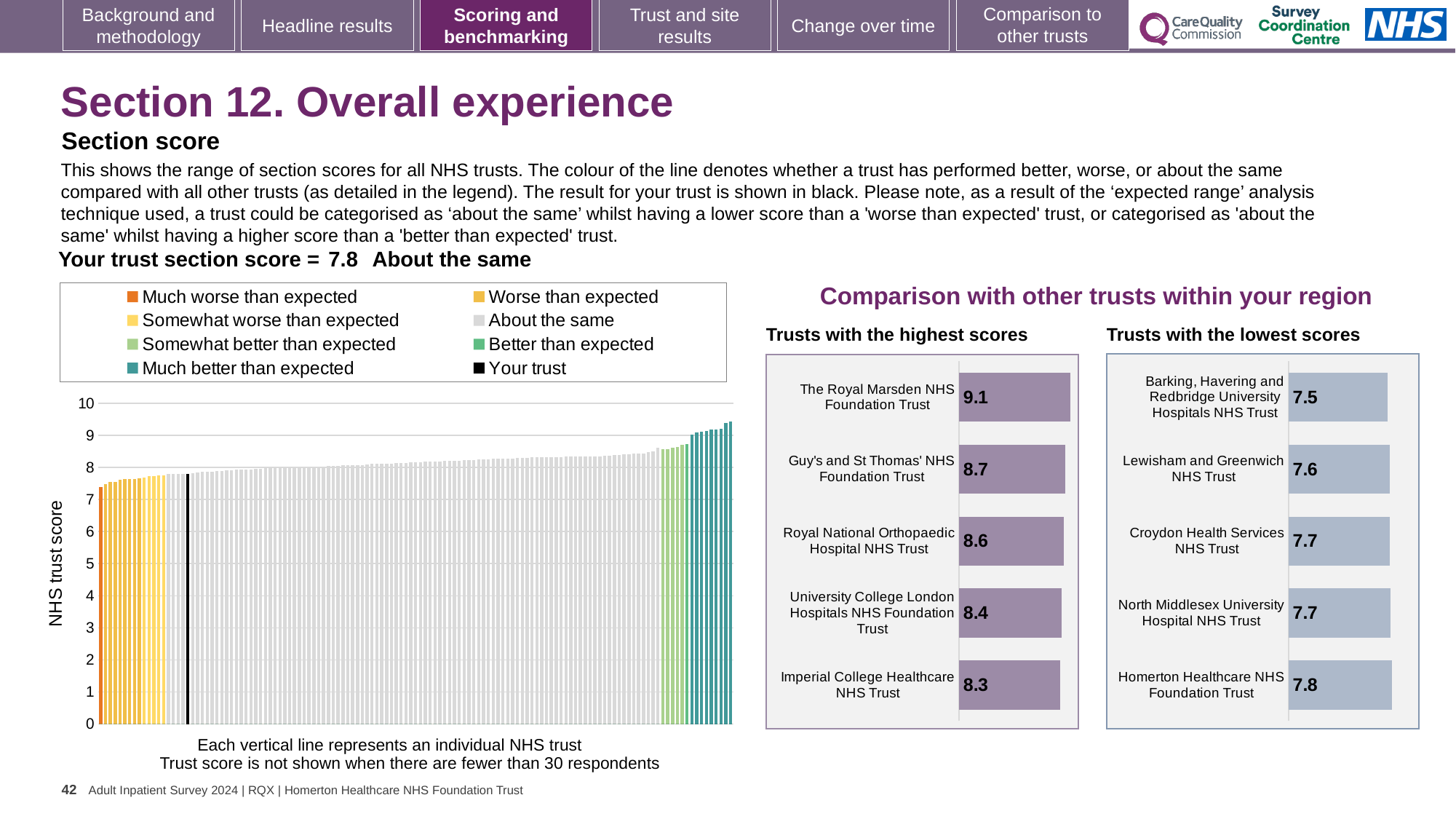
What is the section score for your trust shown above the left-hand chart? 7.8 In the 'Trusts with the lowest scores' chart, what is the score for Lewisham and Greenwich NHS Trust? 7.6 What kind of chart is the large 'NHS trust score' chart on the left of the slide? Bar chart How many trusts are shown in the 'Trusts with the highest scores' chart? 5 In the 'Trusts with the highest scores' chart, what is the score for The Royal Marsden NHS Foundation Trust? 9.1 How many entries does the legend of the left-hand 'NHS trust score' chart list? 8 In the 'Trusts with the highest scores' chart, what is the difference between the scores of The Royal Marsden NHS Foundation Trust and Imperial College Healthcare NHS Trust? 0.8 In the 'Trusts with the highest scores' chart, which has the higher score: Guy's and St Thomas' NHS Foundation Trust or Royal National Orthopaedic Hospital NHS Trust? Guy's and St Thomas' NHS Foundation Trust In the 'Trusts with the highest scores' chart, which trust has the highest score? The Royal Marsden NHS Foundation Trust In the 'Trusts with the lowest scores' chart, which trust has the lowest score? Barking, Havering and Redbridge University Hospitals NHS Trust In the 'Trusts with the lowest scores' chart, what is the difference between the scores of Homerton Healthcare NHS Foundation Trust and Barking, Havering and Redbridge University Hospitals NHS Trust? 0.3 In the left-hand 'NHS trust score' chart, do the bar heights rise or fall from left to right? Rise